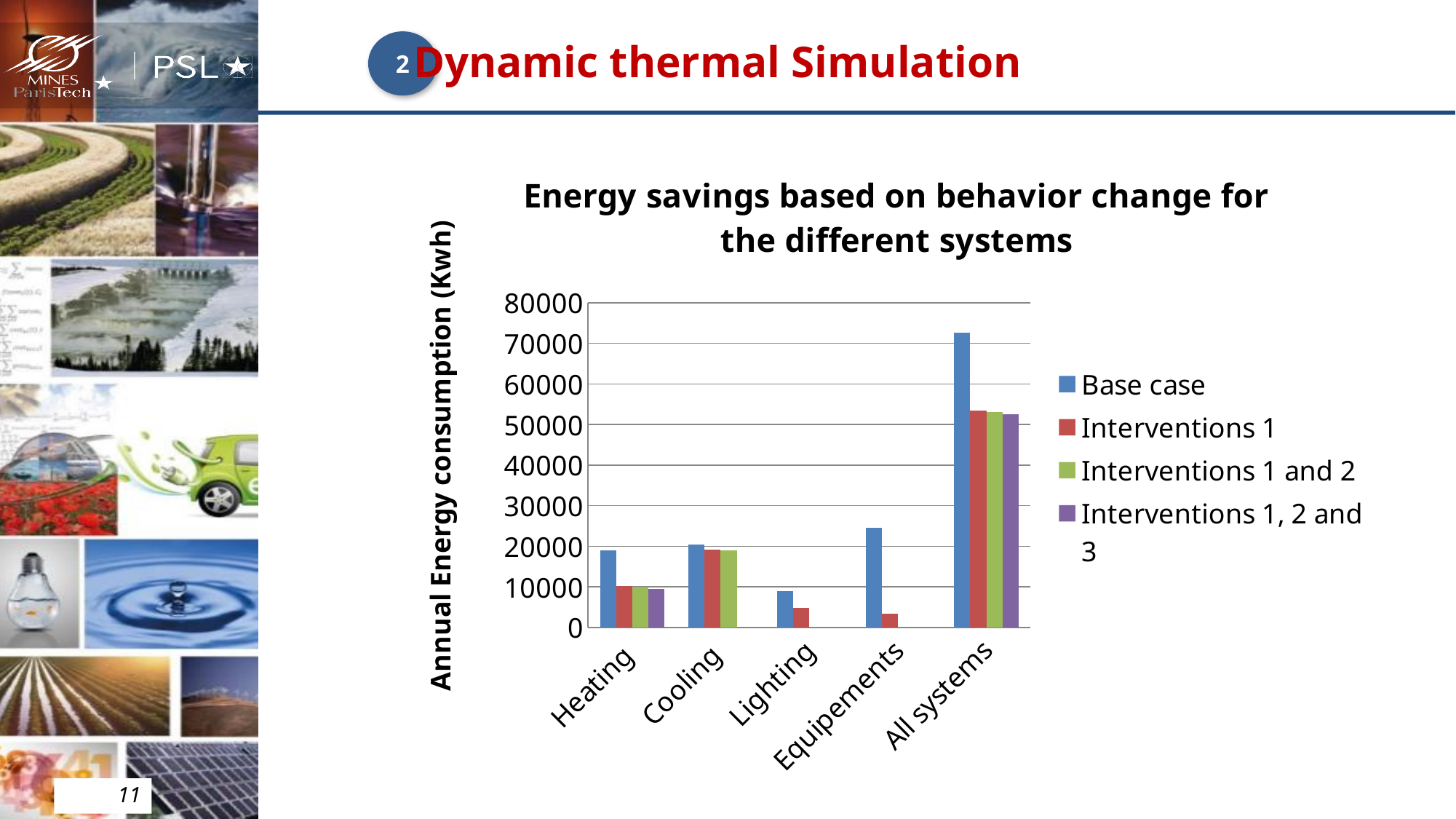
What kind of chart is shown on the slide? bar chart What is the label of the y axis? Annual Energy consumption (Kwh) Which category has the lowest Base case value? Lighting Which is larger for Interventions 1: Heating or Cooling? Cooling Is the Base case value for All systems greater or less than 70000? greater How many categories are shown on the x axis? 5 Is the Interventions 1 value for Lighting greater or less than 10000? less Which is larger for the Base case: Equipements or Cooling? Equipements Is the Base case value for Heating greater or less than 20000? less How many series does the legend list? 4 Which category has the highest Base case value? All systems